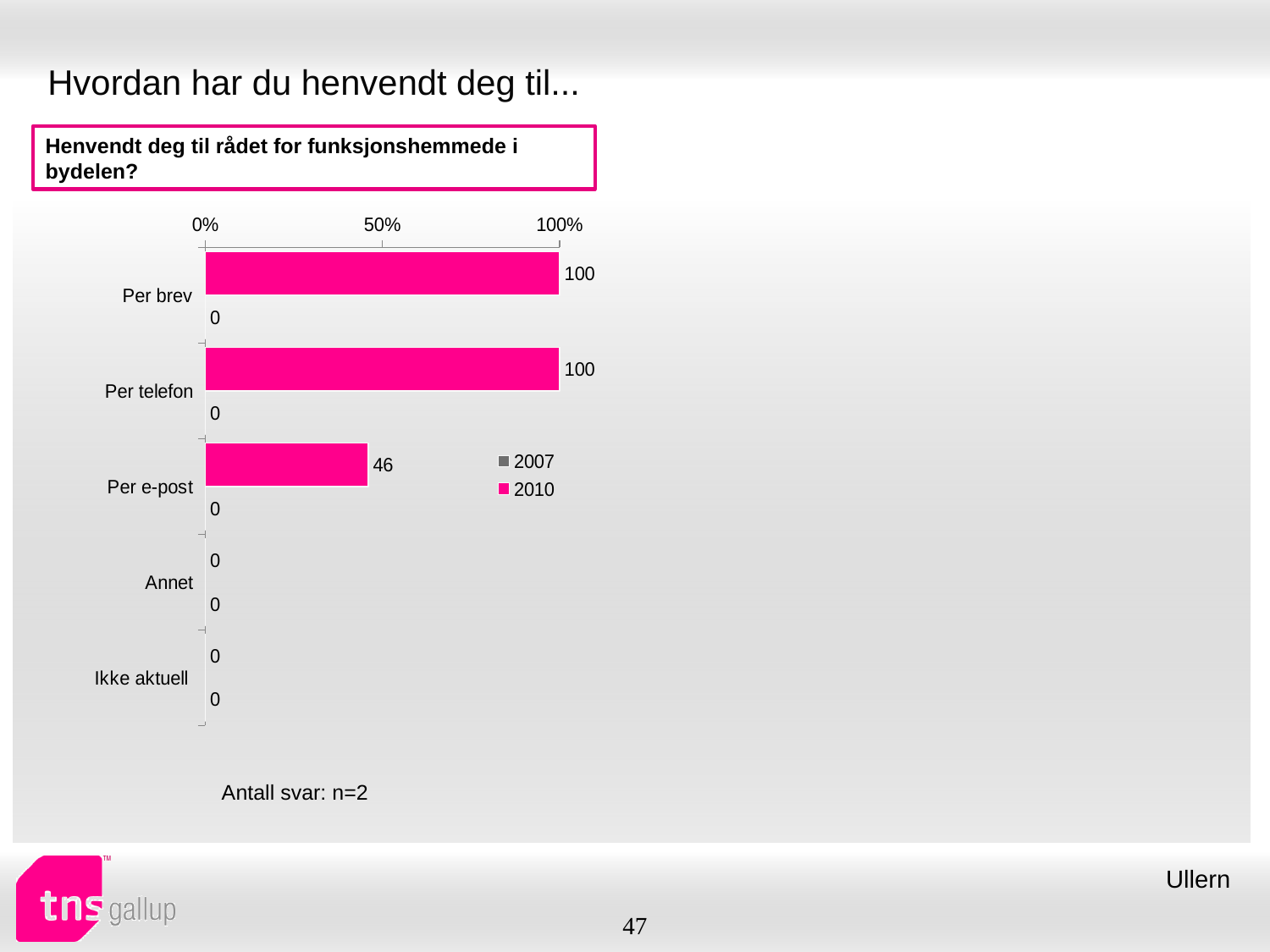
How many series does the legend list? 2 How many categories are shown on the chart? 5 Is the 2010 value for Per e-post greater or less than 50%? less Which is larger, the 2010 value for Per brev or the 2010 value for Per e-post? Per brev What is the 2010 value for Per e-post? 46 What type of chart is shown on the slide? bar chart Which colour represents the 2010 series in the legend? pink What is the 2010 value for Annet? 0 What is the 2010 value for Per brev? 100 Which category has the lowest 2010 value among Per brev, Per telefon and Per e-post? Per e-post What is the difference between the 2010 values for Per telefon and Per e-post? 54 What is the 2007 value for Per telefon? 0